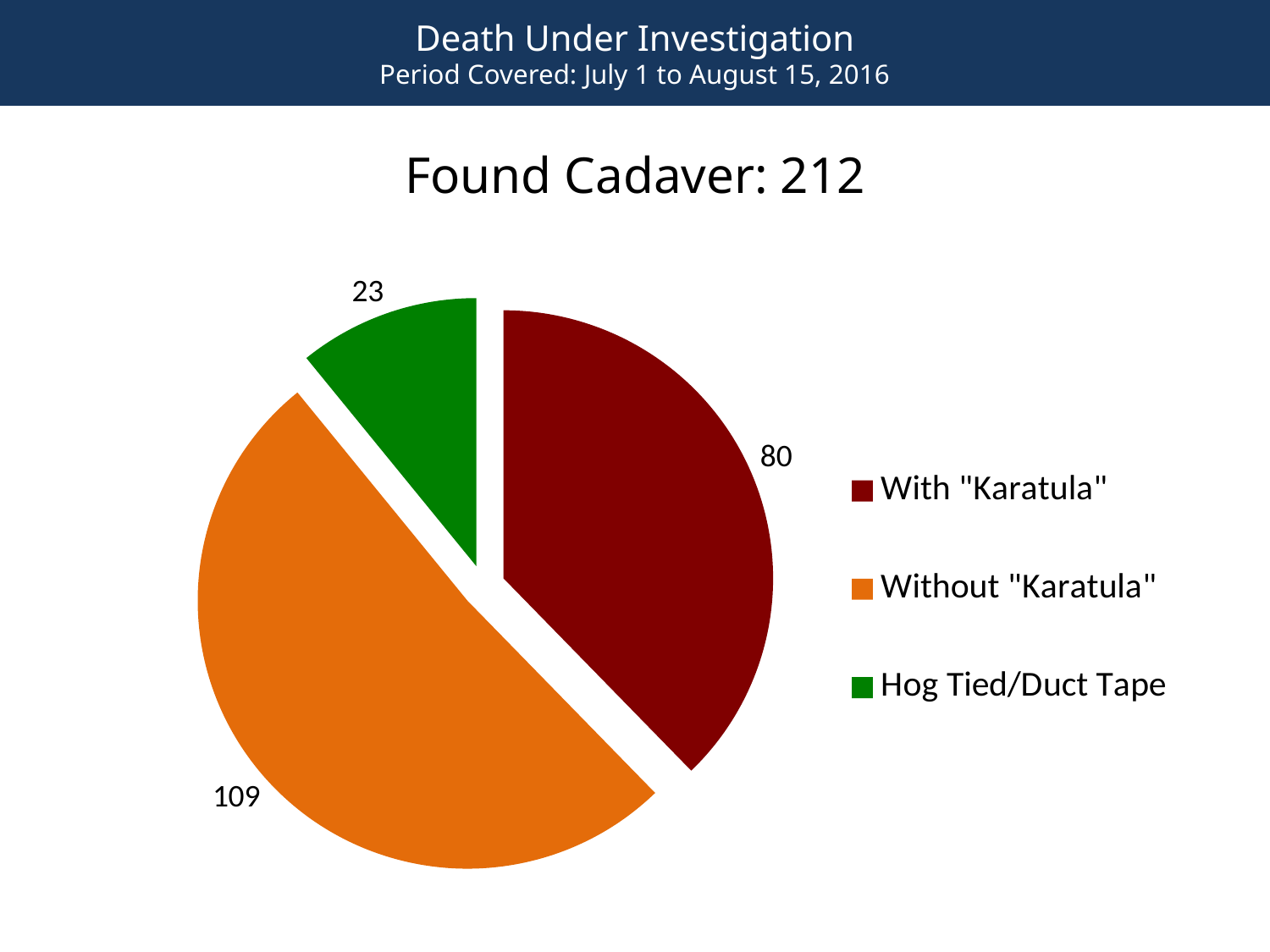
Which category has the smallest slice of the pie? Hog Tied/Duct Tape What is the title of the chart? Found Cadaver: 212 What is the value for the Without "Karatula" slice? 109 What kind of chart is shown on the slide? Pie chart How many slices does the pie chart have? 3 What is the difference between the With "Karatula" and Hog Tied/Duct Tape values? 57 What is the value for the With "Karatula" slice? 80 Which is larger, the With "Karatula" slice or the Hog Tied/Duct Tape slice? With "Karatula" Which category has the largest slice of the pie? Without "Karatula" What is the value for the Hog Tied/Duct Tape slice? 23 What is the difference between the Without "Karatula" and With "Karatula" values? 29